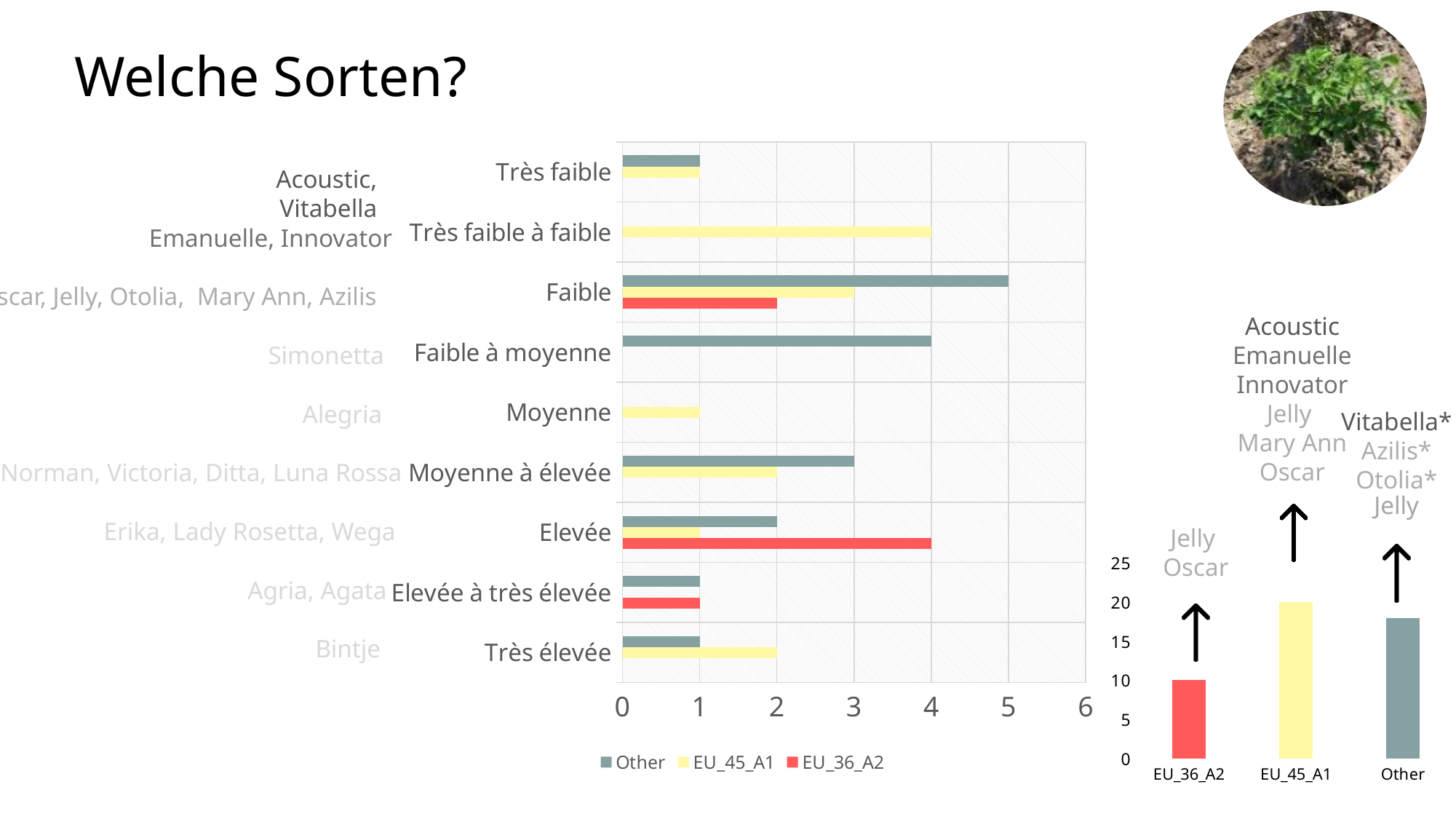
In the small bar chart at the bottom right, what is the value for EU_36_A2? 10 How many categories are shown on the vertical axis of the large horizontal bar chart? 9 How many series does the legend of the large horizontal bar chart list? 3 In the small bar chart at the bottom right, which category has the lowest value? EU_36_A2 In the large horizontal bar chart, what is the value of EU_45_A1 for Très faible à faible? 4 In the large horizontal bar chart, what is the value of EU_36_A2 for the Elevée category? 4 In the large horizontal bar chart, which category has the highest value for the Other series? Faible In the small bar chart at the bottom right, is the value for Other greater or less than 15? greater In the large horizontal bar chart, what is the value of the Other series for the Faible category? 5 What type of chart is the large chart in the centre of the slide? bar chart In the large horizontal bar chart, what is the difference between the Other value and the EU_36_A2 value for the Faible category? 3 In the large horizontal bar chart, for the Elevée category, which series has the larger value: Other or EU_36_A2? EU_36_A2